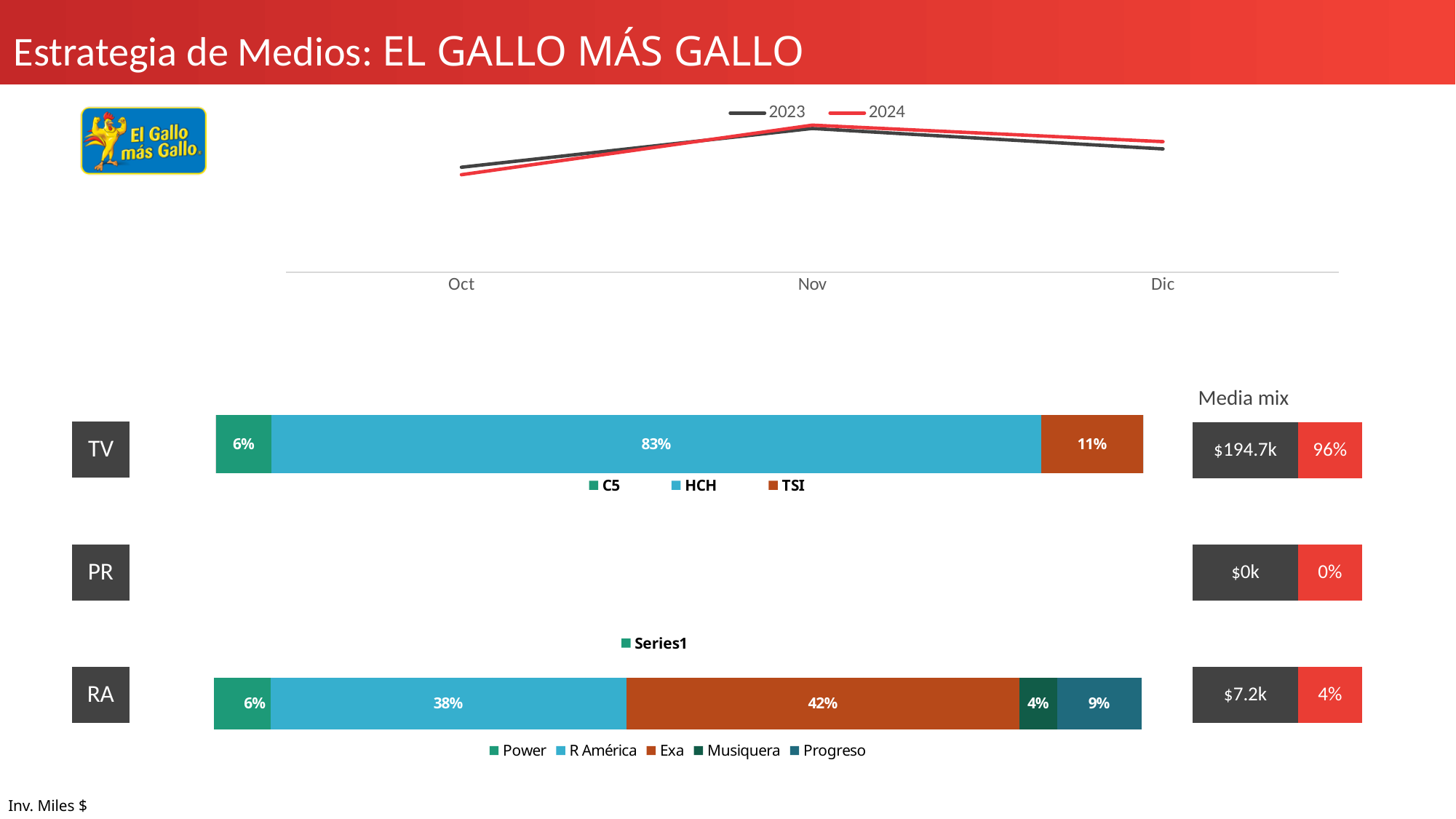
In the TV bar chart, what percentage is shown for HCH? 83% In the top line chart, does the 2024 line rise or fall from Oct to Nov? rise In the RA bar chart, how many series does the legend list? 5 In the RA bar chart, which segment is the largest? Exa In the top line chart, what are the categories shown on the x axis? Oct, Nov, Dic In the RA bar chart, what percentage is shown for Exa? 42% In the TV bar chart, what is the difference between the TSI and C5 percentages? 5% In the RA bar chart, which is larger, Progreso or Musiquera? Progreso In the TV bar chart, which segment is the smallest? C5 In the top line chart, how many series does the legend list? 2 In the top line chart, does the 2023 line rise or fall from Nov to Dic? fall In the top line chart, which series is higher at Oct, 2023 or 2024? 2023